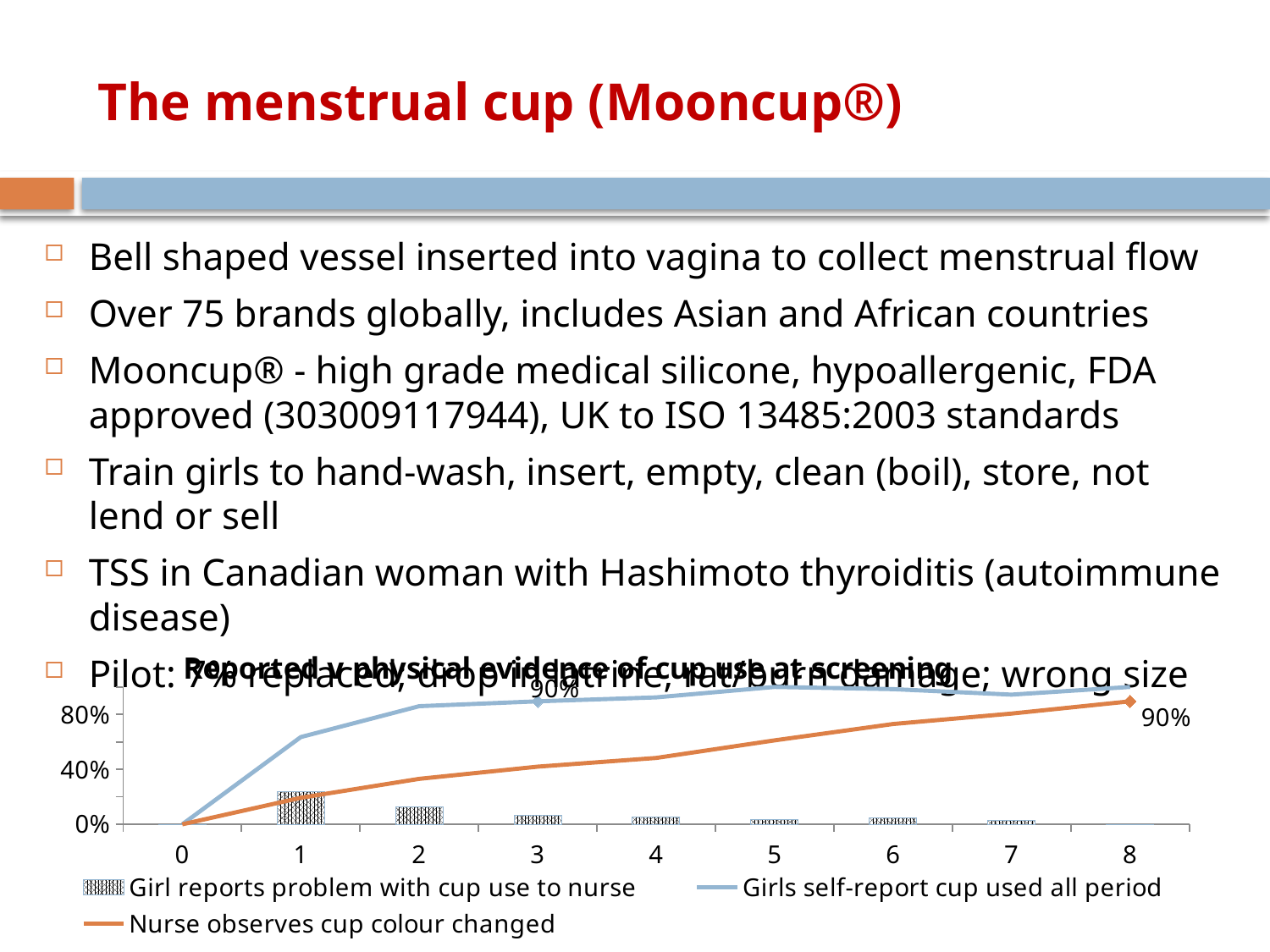
How many series does the chart legend list? 3 At screening 1, which is larger: 'Girls self-report cup used all period' or 'Nurse observes cup colour changed'? Girls self-report cup used all period Is the value for 'Nurse observes cup colour changed' at screening 1 greater or less than 40%? less What is the title of the chart? Reported v physical evidence of cup use at screening What value is labelled for 'Nurse observes cup colour changed' at screening 8? 90% What value is labelled for 'Girls self-report cup used all period' at screening 3? 90% What kind of chart is used for the 'Girl reports problem with cup use to nurse' series? bar chart Does the 'Nurse observes cup colour changed' line rise or fall from screening 0 to screening 8? rise At which screening is the 'Girl reports problem with cup use to nurse' bar highest? 1 Is the value for 'Girls self-report cup used all period' at screening 2 greater or less than 80%? greater Is the value for 'Girls self-report cup used all period' at screening 1 greater or less than 40%? greater How many screening points are shown on the x axis? 9